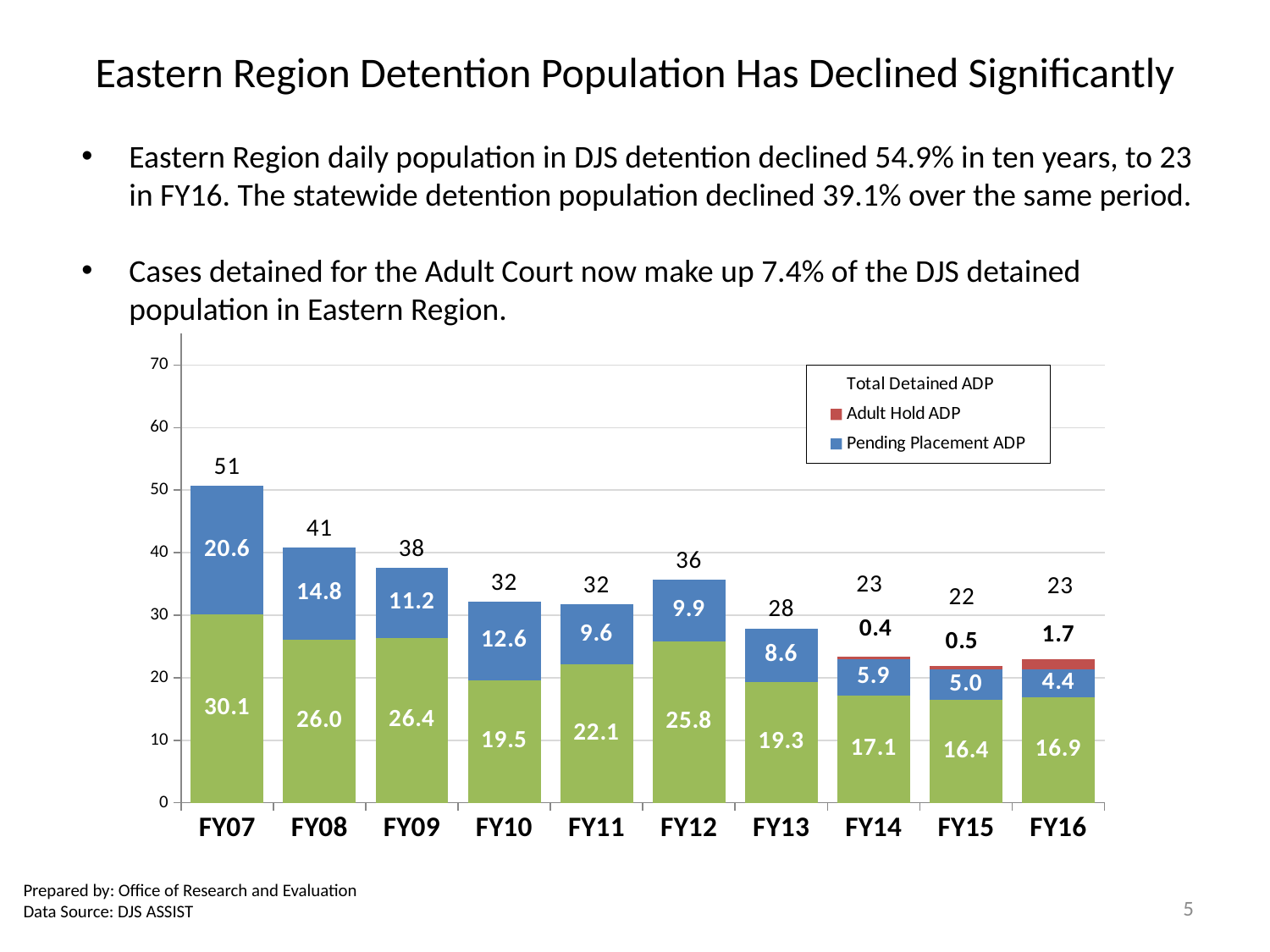
What is the Pending Placement ADP value for FY10? 12.6 What is the total detained ADP shown above the bar for FY07? 51 How many fiscal years are shown on the x axis? 10 What is the difference between the Pending Placement ADP in FY07 and in FY08? 5.8 What is the difference between the total detained ADP in FY07 and in FY16? 28 Which fiscal year has the highest total detained ADP? FY07 Which is larger, the Pending Placement ADP in FY08 or in FY09? FY08 How many series does the legend list? 3 What is the Adult Hold ADP value for FY16? 1.7 What kind of chart is shown on the slide? Stacked bar chart Which fiscal year has the lowest total detained ADP? FY15 Do the total detained ADP values generally rise or fall from FY07 to FY16? Fall